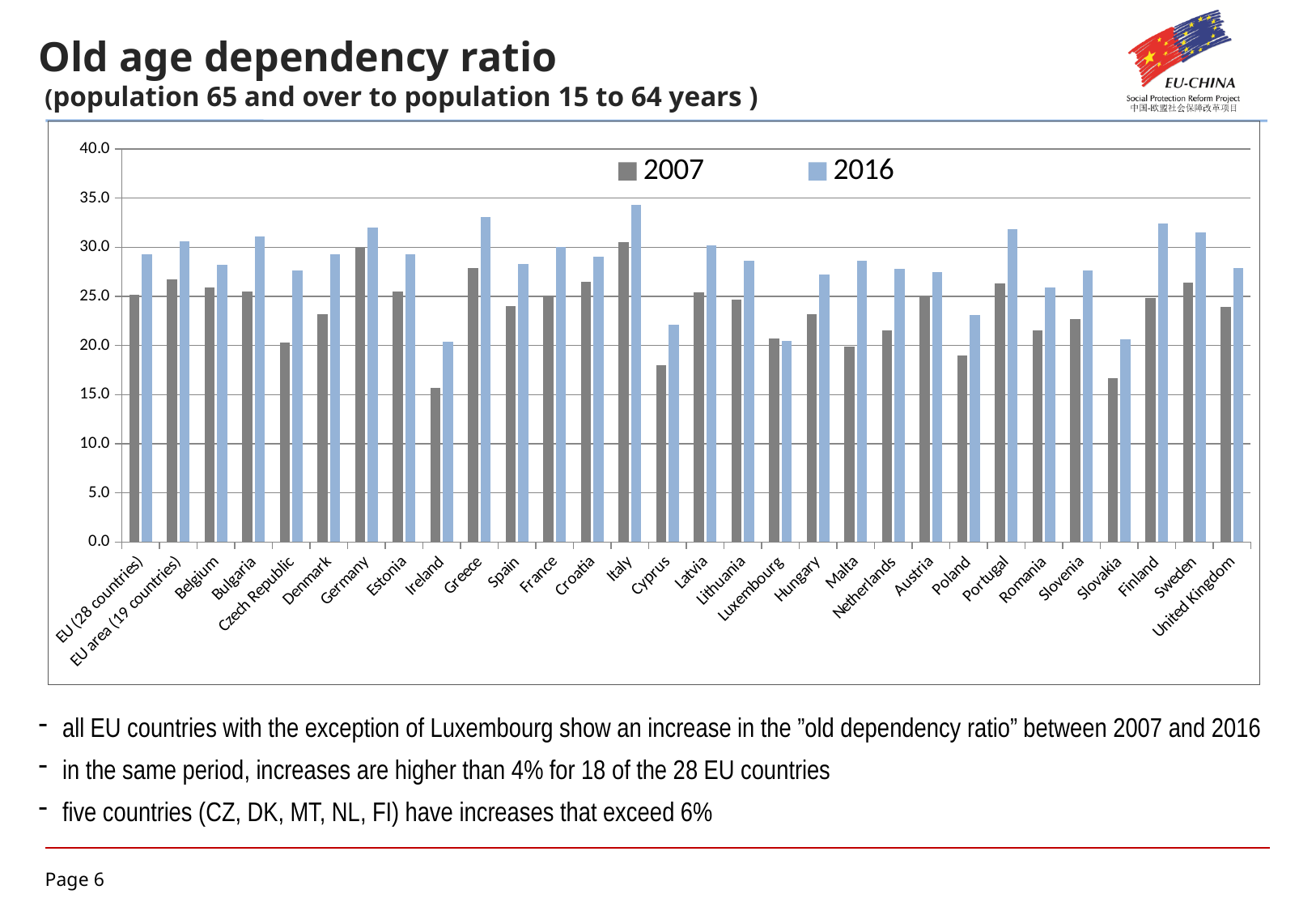
Is the value for Luxembourg in 2016 greater or less than 25.0? less How many categories are shown along the x axis? 30 For Ireland, which series has the larger value: 2007 or 2016? 2016 Is the value for Italy in 2016 greater or less than 30.0? greater Is the value for Ireland in 2007 greater or less than 20.0? less How many series does the legend list? 2 Which is larger for 2016: Germany or Denmark? Germany What kind of chart is shown on the slide? bar chart Which category has the highest value for 2016? Italy What are the two series named in the legend? 2007 and 2016 Which category has the lowest value for 2007? Ireland